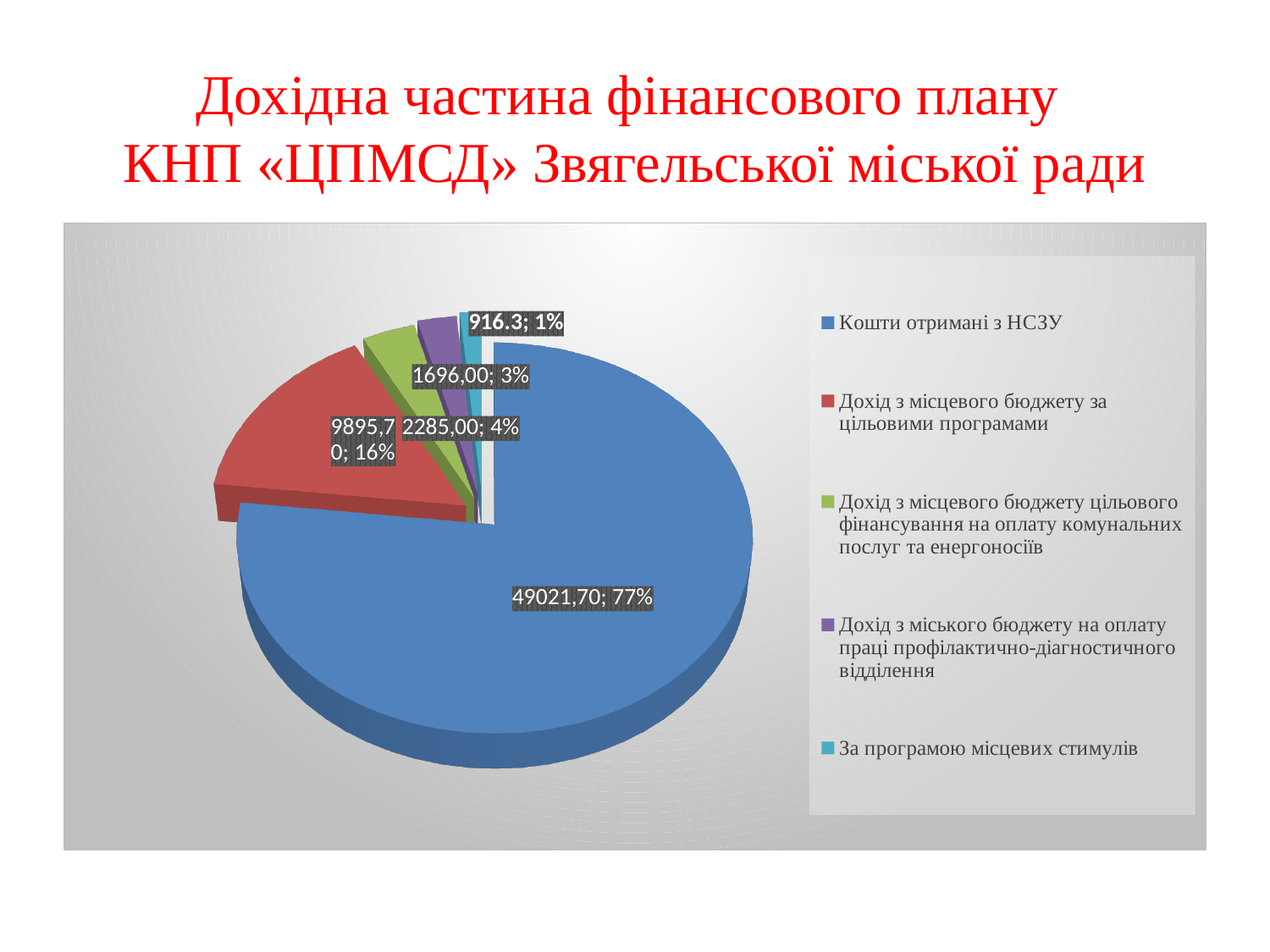
What colour is the slice for "Кошти отримані з НСЗУ"? blue What value is shown for "Дохід з місцевого бюджету за цільовими програмами"? 9895,70 What kind of chart is shown on the slide? pie chart What share of the pie does "Дохід з місцевого бюджету за цільовими програмами" take? 16% How many slices does the pie chart have? 5 Which is larger: the slice labelled 2285,00 or the slice labelled 1696,00? 2285,00 What share of the pie does "Кошти отримані з НСЗУ" take? 77% How many entries does the legend list? 5 What share of the pie does "За програмою місцевих стимулів" take? 1% What value is shown for "Кошти отримані з НСЗУ"? 49021,70 Which category has the smallest slice of the pie? За програмою місцевих стимулів Which category has the largest slice of the pie? Кошти отримані з НСЗУ